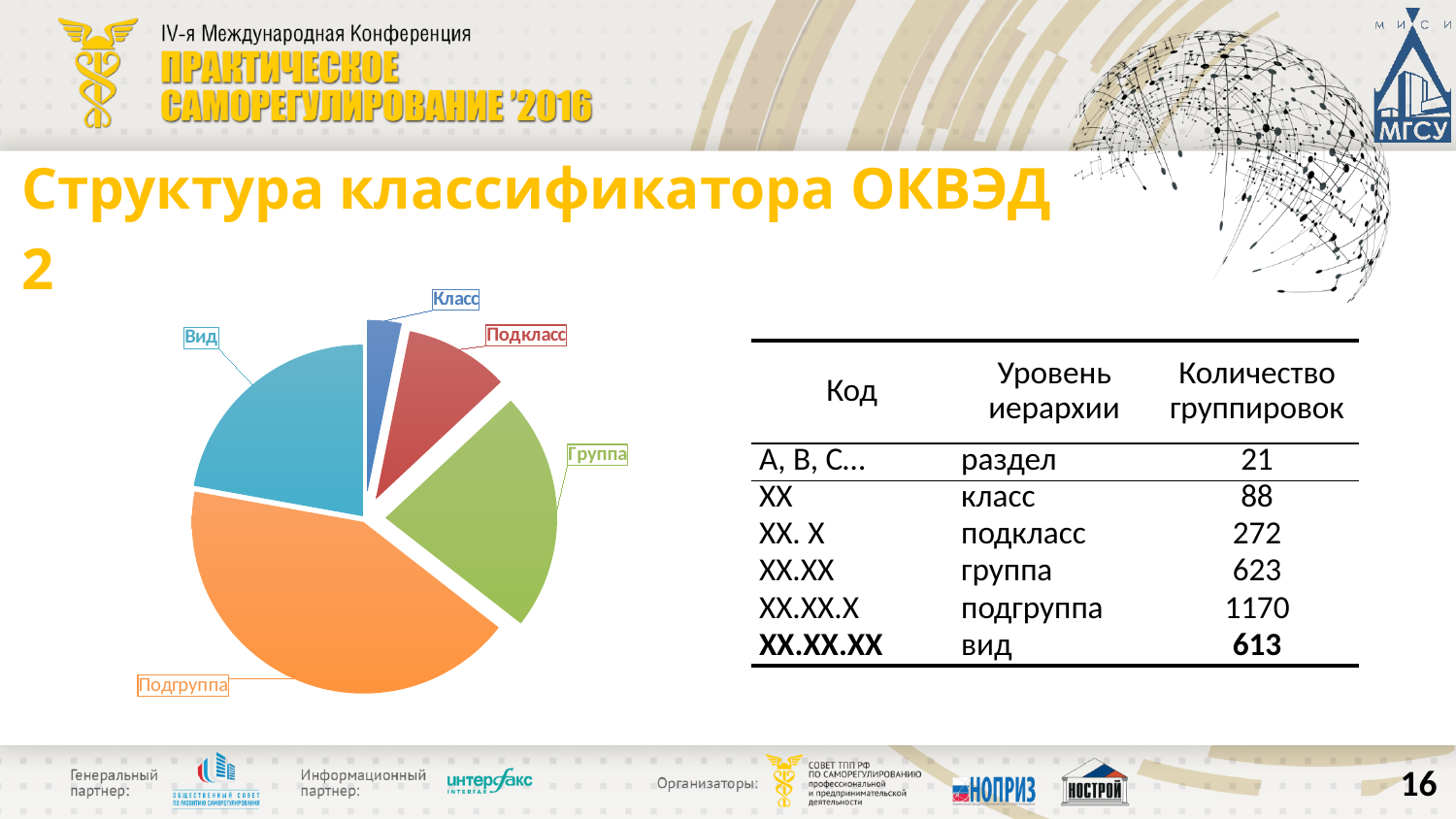
Which slice is larger in the pie chart, Подгруппа or Группа? Подгруппа What kind of chart is shown on the slide? pie chart Which slice of the pie chart is the smallest? Класс Which slice of the pie chart is coloured blue? Класс Which slice is larger in the pie chart, Подкласс or Класс? Подкласс How many slices does the pie chart have? 5 Which slice of the pie chart is the largest? Подгруппа Which slice is larger in the pie chart, Подгруппа or Вид? Подгруппа What colour is the Подгруппа slice in the pie chart? orange